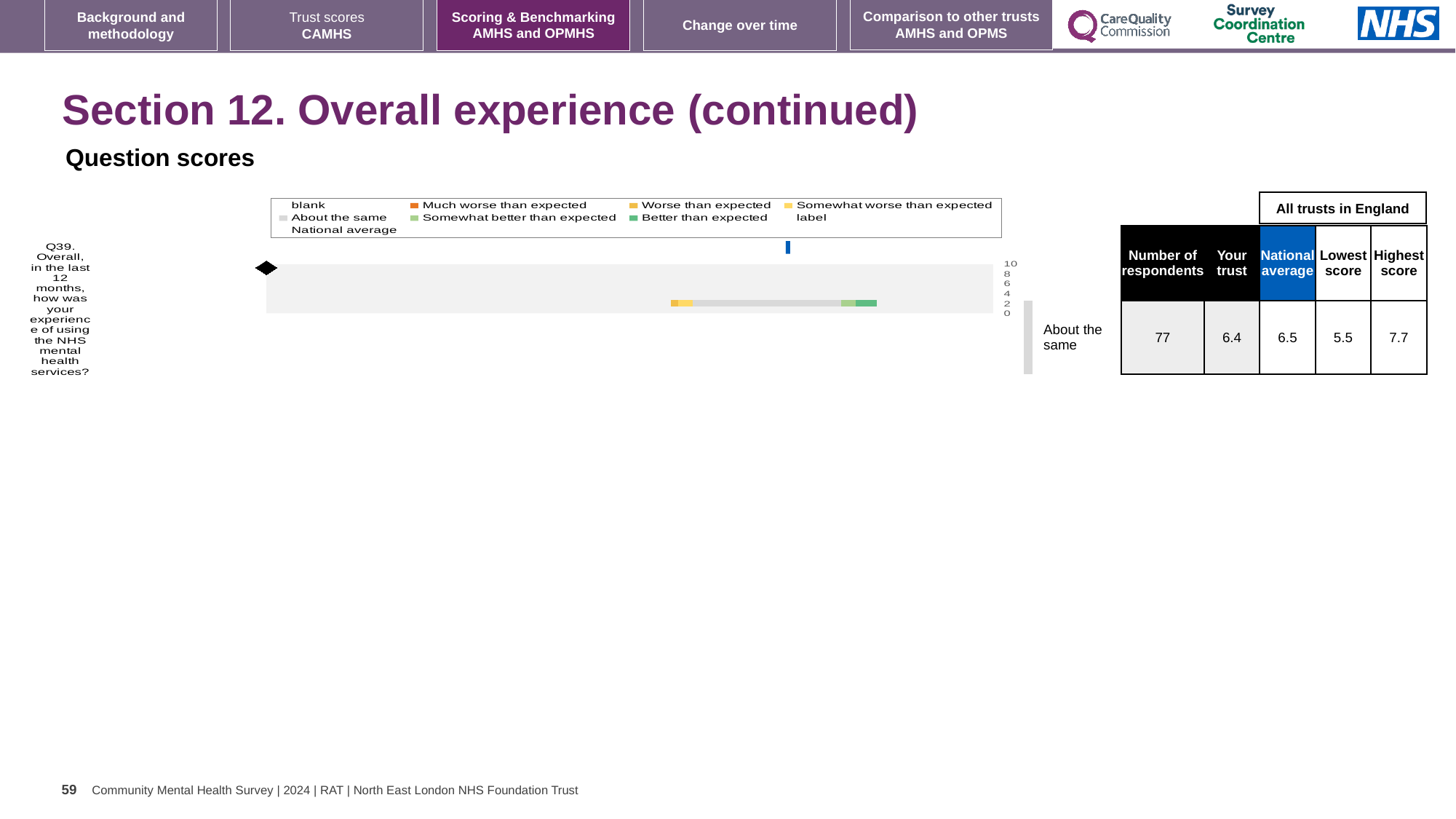
What is the highest value shown on the chart's score axis? 10 What is the national average score for Q39? 6.5 What is the highest score among all trusts in England for Q39? 7.7 What is the 'Your trust' score for Q39? 6.4 What kind of chart is shown on the slide? bar chart What is the lowest score among all trusts in England for Q39? 5.5 Which benchmark category is Q39 assigned to? About the same What is the difference between the national average and the 'Your trust' score for Q39? 0.1 How many respondents answered Q39? 77 What is the difference between the highest score and the lowest score for Q39? 2.2 Which is larger for Q39, the 'Your trust' score or the national average? National average How many questions are plotted in the chart? 1